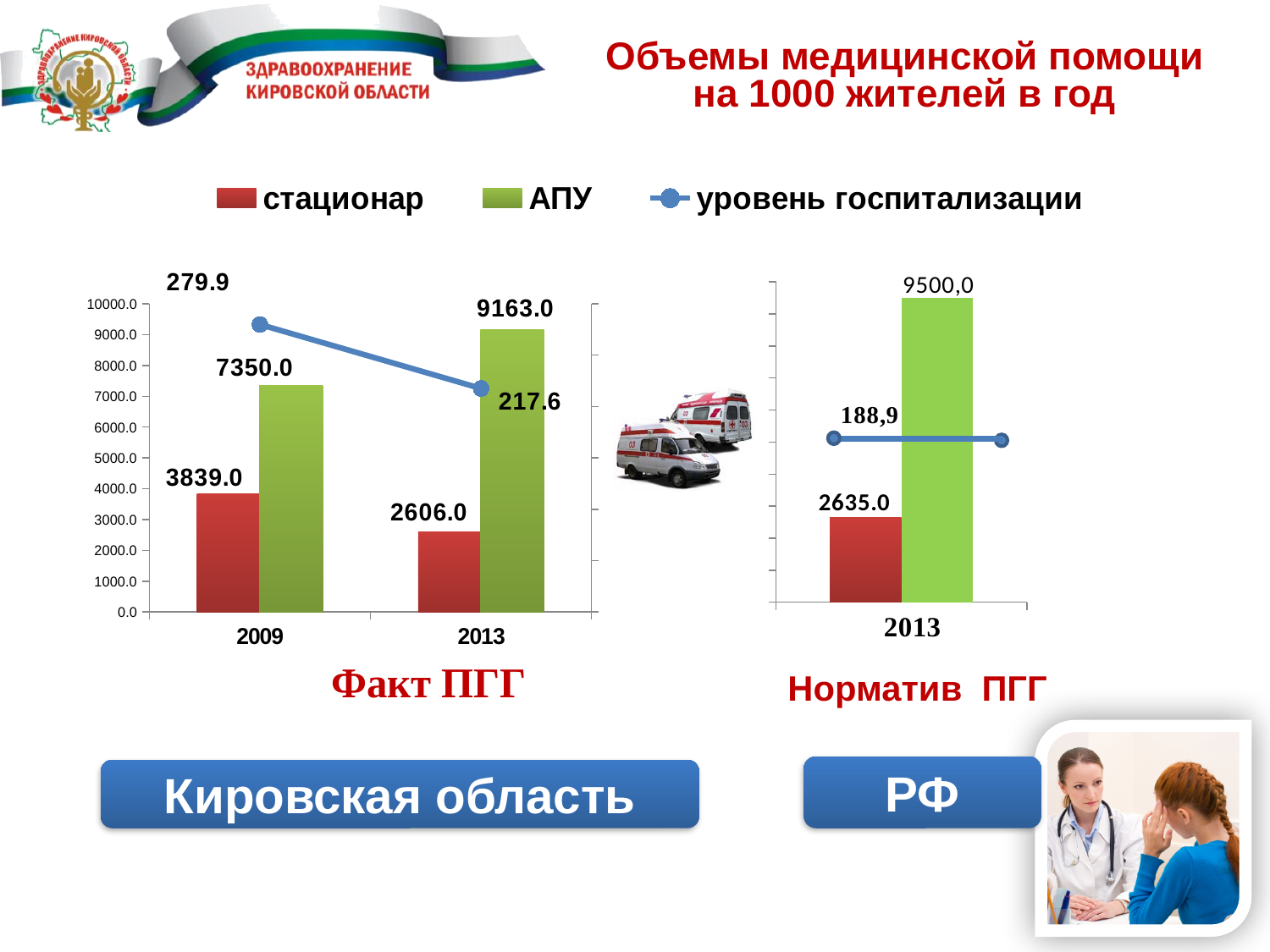
In the left chart (Факт ПГГ), what is the уровень госпитализации value in 2013? 217.6 How many series does the legend list? 3 In the left chart (Факт ПГГ), what is the difference between the АПУ values for 2013 and 2009? 1813.0 In the left chart (Факт ПГГ), what is the value for стационар in 2009? 3839.0 In the right chart (Норматив ПГГ), what is the value for АПУ in 2013? 9500,0 In the left chart (Факт ПГГ), by how much did the стационар value decrease from 2009 to 2013? 1233.0 In the left chart (Факт ПГГ), what is the value for АПУ in 2013? 9163.0 In the left chart (Факт ПГГ), which is larger in 2013: стационар or АПУ? АПУ In the right chart (Норматив ПГГ), what is the уровень госпитализации value? 188,9 In the left chart (Факт ПГГ), does the уровень госпитализации line rise or fall from 2009 to 2013? fall What kind of chart is the left chart (Факт ПГГ)? bar chart with a line How many year categories are shown on the x axis of the left chart (Факт ПГГ)? 2